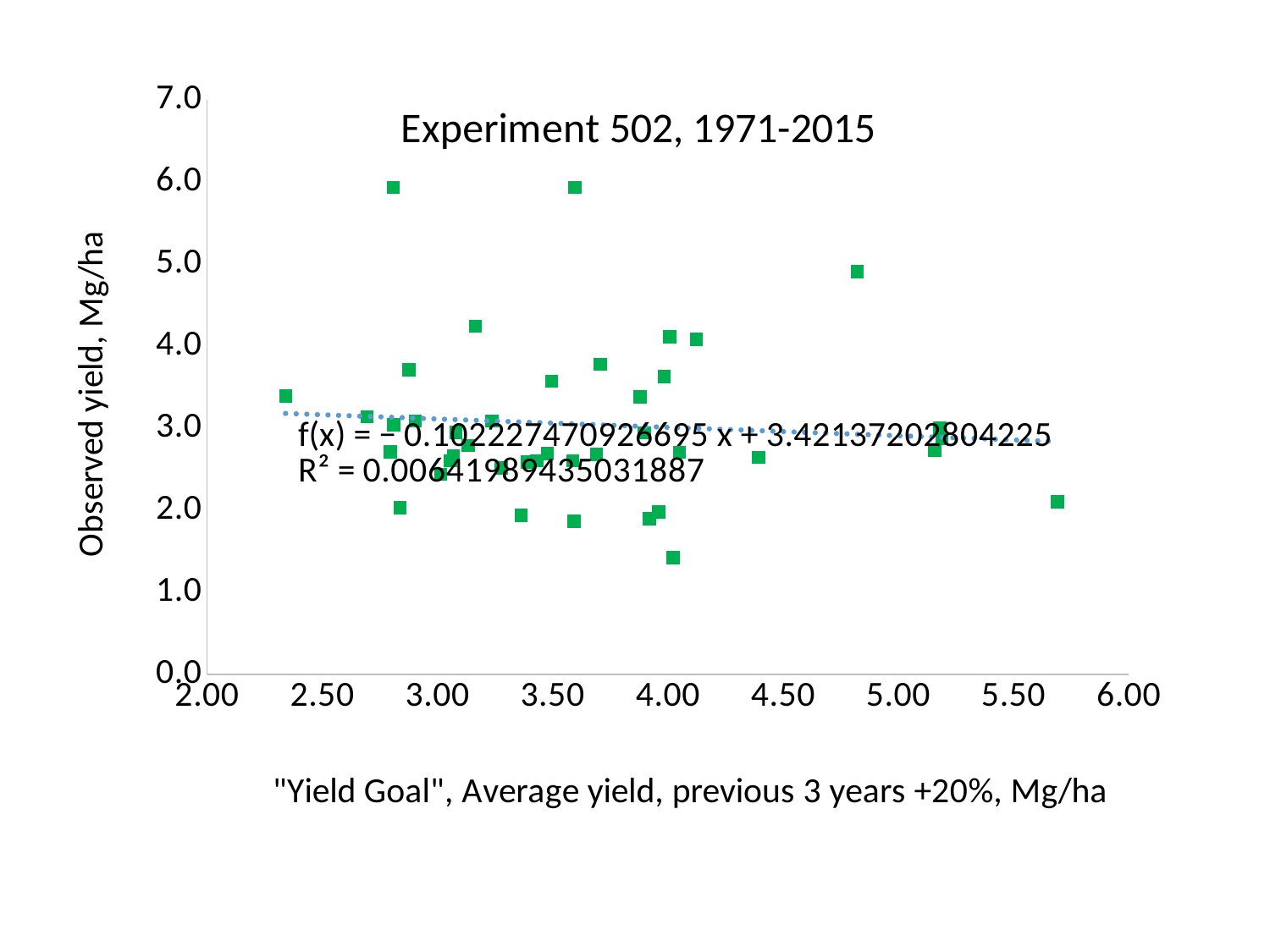
What is the equation of the trendline shown on the chart? f(x) = − 0.102227470926695 x + 3.42137202804225 Is the lowest observed yield plotted on the chart greater or less than 2.0 Mg/ha? less Does the trendline rise or fall as the yield goal increases along the x axis? Falls Is the slope of the trendline positive or negative? Negative What is the title of the chart? Experiment 502, 1971-2015 What is the range of the horizontal axis? 2.00 to 6.00 What is the maximum value shown on the vertical axis? 7.0 Is the observed yield for the point with the largest yield goal (around 5.70) greater or less than 3.0 Mg/ha? less Is the highest observed yield plotted on the chart greater or less than 5.0 Mg/ha? greater What kind of chart is shown on the slide? Scatter chart What R² value is printed on the chart? R² = 0.00641989435031887 What is the label of the vertical axis? Observed yield, Mg/ha